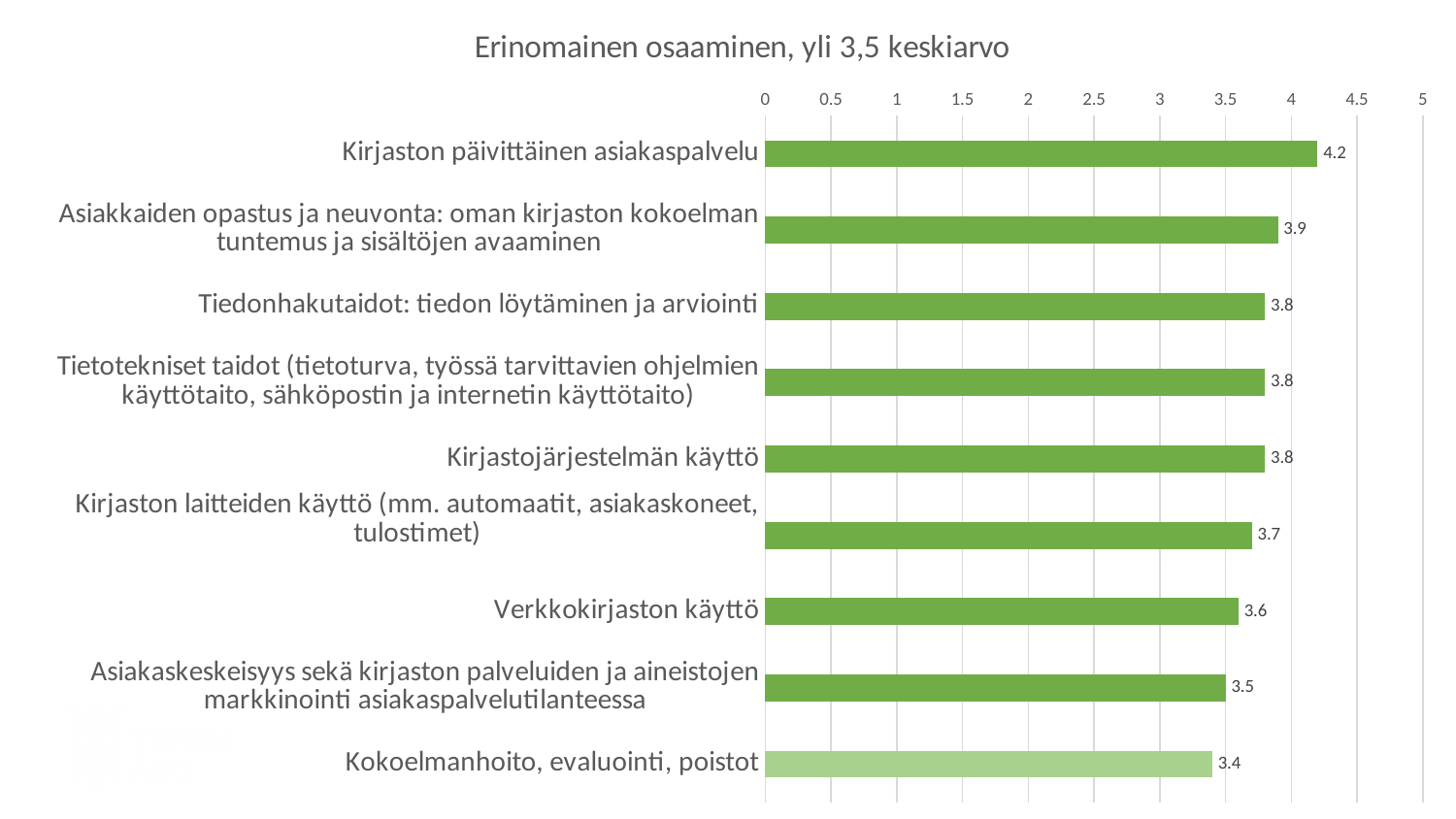
Which category has the lowest value? Kokoelmanhoito, evaluointi, poistot What is the value for Kokoelmanhoito, evaluointi, poistot? 3.4 What is the title of the chart? Erinomainen osaaminen, yli 3,5 keskiarvo What is the difference between the values for Kirjaston päivittäinen asiakaspalvelu and Kokoelmanhoito, evaluointi, poistot? 0.8 What is the value for Verkkokirjaston käyttö? 3.6 How many categories are shown in the chart? 9 What kind of chart is shown on the slide? bar chart What is the value for Kirjaston päivittäinen asiakaspalvelu? 4.2 Which category has the highest value? Kirjaston päivittäinen asiakaspalvelu Which is larger: the value for Verkkokirjaston käyttö or the value for Tiedonhakutaidot: tiedon löytäminen ja arviointi? Tiedonhakutaidot: tiedon löytäminen ja arviointi Is the value for Kokoelmanhoito, evaluointi, poistot greater or less than 3.5? less What is the value for Kirjastojärjestelmän käyttö? 3.8